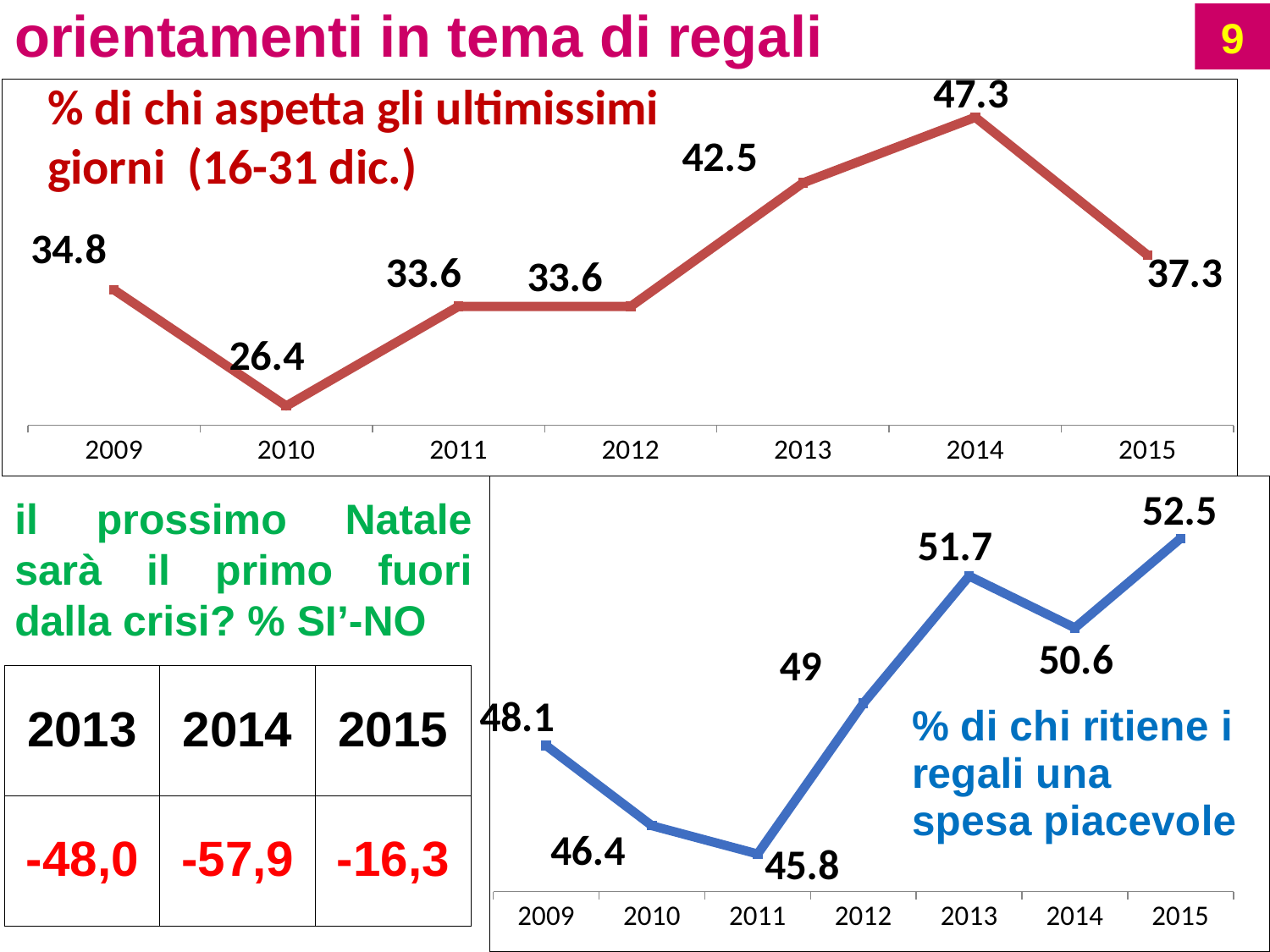
In the bottom chart (% di chi ritiene i regali una spesa piacevole), what is the value for 2012? 49 In the bottom chart (% di chi ritiene i regali una spesa piacevole), what is the difference between the 2015 and 2009 values? 4.4 In the top chart (% di chi aspetta gli ultimissimi giorni), which year has the lowest value? 2010 In the top chart (% di chi aspetta gli ultimissimi giorni), what is the value for 2010? 26.4 In the top chart (% di chi aspetta gli ultimissimi giorni), what is the value for 2014? 47.3 What type of chart is the bottom chart (% di chi ritiene i regali una spesa piacevole)? Line chart In the top chart (% di chi aspetta gli ultimissimi giorni), which year has the highest value? 2014 In the bottom chart (% di chi ritiene i regali una spesa piacevole), is the value for 2013 or 2014 larger? 2013 In the bottom chart (% di chi ritiene i regali una spesa piacevole), what is the value for 2015? 52.5 In the top chart (% di chi aspetta gli ultimissimi giorni), how many years are plotted? 7 In the top chart (% di chi aspetta gli ultimissimi giorni), what is the difference between the 2014 and 2015 values? 10 In the bottom chart (% di chi ritiene i regali una spesa piacevole), which year has the lowest value? 2011